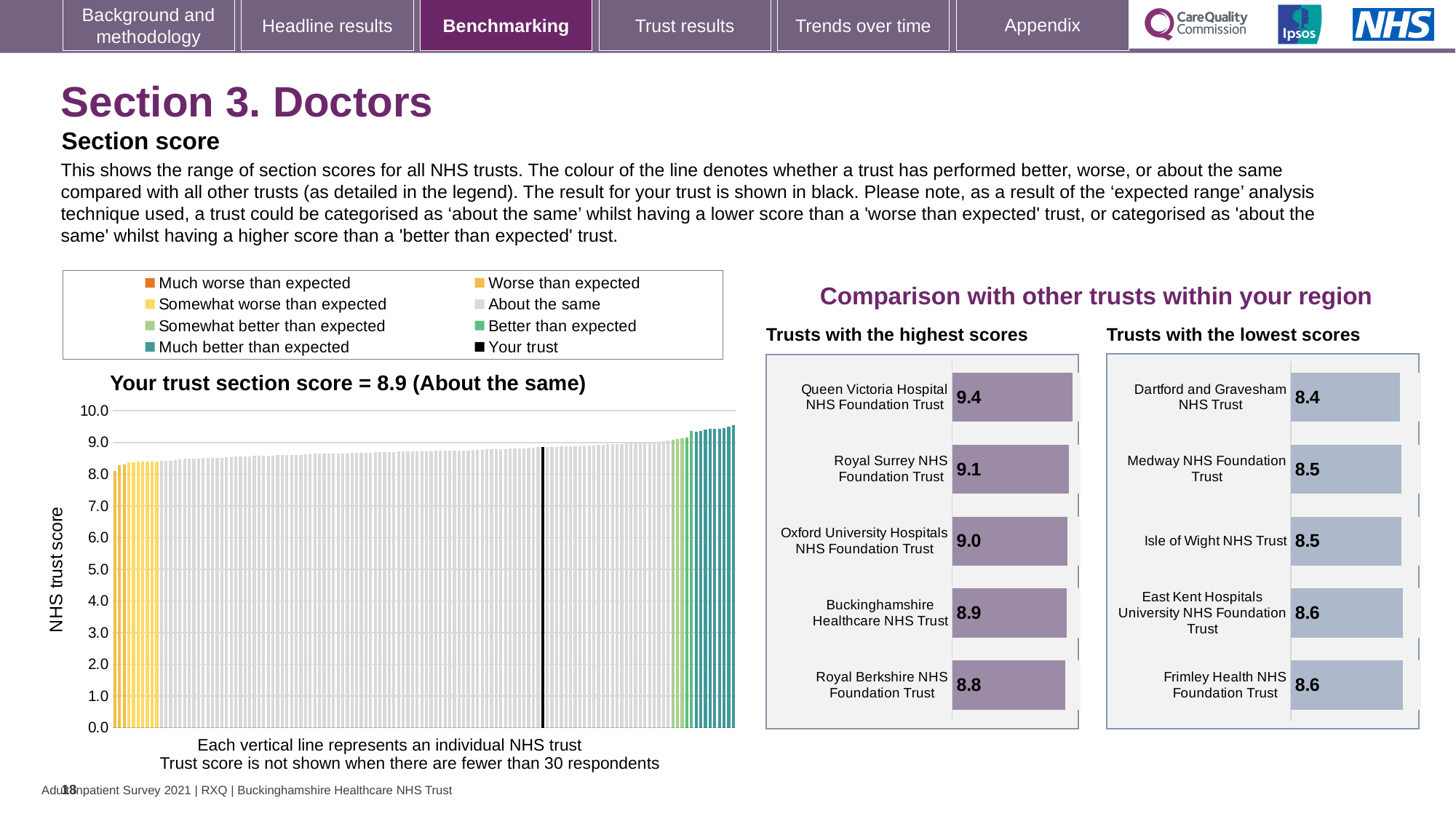
In the 'Trusts with the highest scores' chart, what is the difference between the scores of Queen Victoria Hospital NHS Foundation Trust and Royal Berkshire NHS Foundation Trust? 0.6 In the 'Trusts with the highest scores' chart, what is the score for Queen Victoria Hospital NHS Foundation Trust? 9.4 In the main chart on the left, do the trust scores rise or fall from left to right along the x axis? Rise In the 'Trusts with the lowest scores' chart, what is the score for Dartford and Gravesham NHS Trust? 8.4 In the 'Trusts with the highest scores' chart, which has the higher score: Royal Surrey NHS Foundation Trust or Oxford University Hospitals NHS Foundation Trust? Royal Surrey NHS Foundation Trust What kind of chart is the main chart on the left showing all NHS trusts? Bar chart How many entries does the legend above the main chart on the left list? 8 How many trusts are shown in the 'Trusts with the lowest scores' chart? 5 In the main chart on the left, what is your trust's section score? 8.9 How many trusts are shown in the 'Trusts with the highest scores' chart? 5 In the 'Trusts with the lowest scores' chart, which trust has the lowest score? Dartford and Gravesham NHS Trust In the 'Trusts with the highest scores' chart, which trust has the highest score? Queen Victoria Hospital NHS Foundation Trust